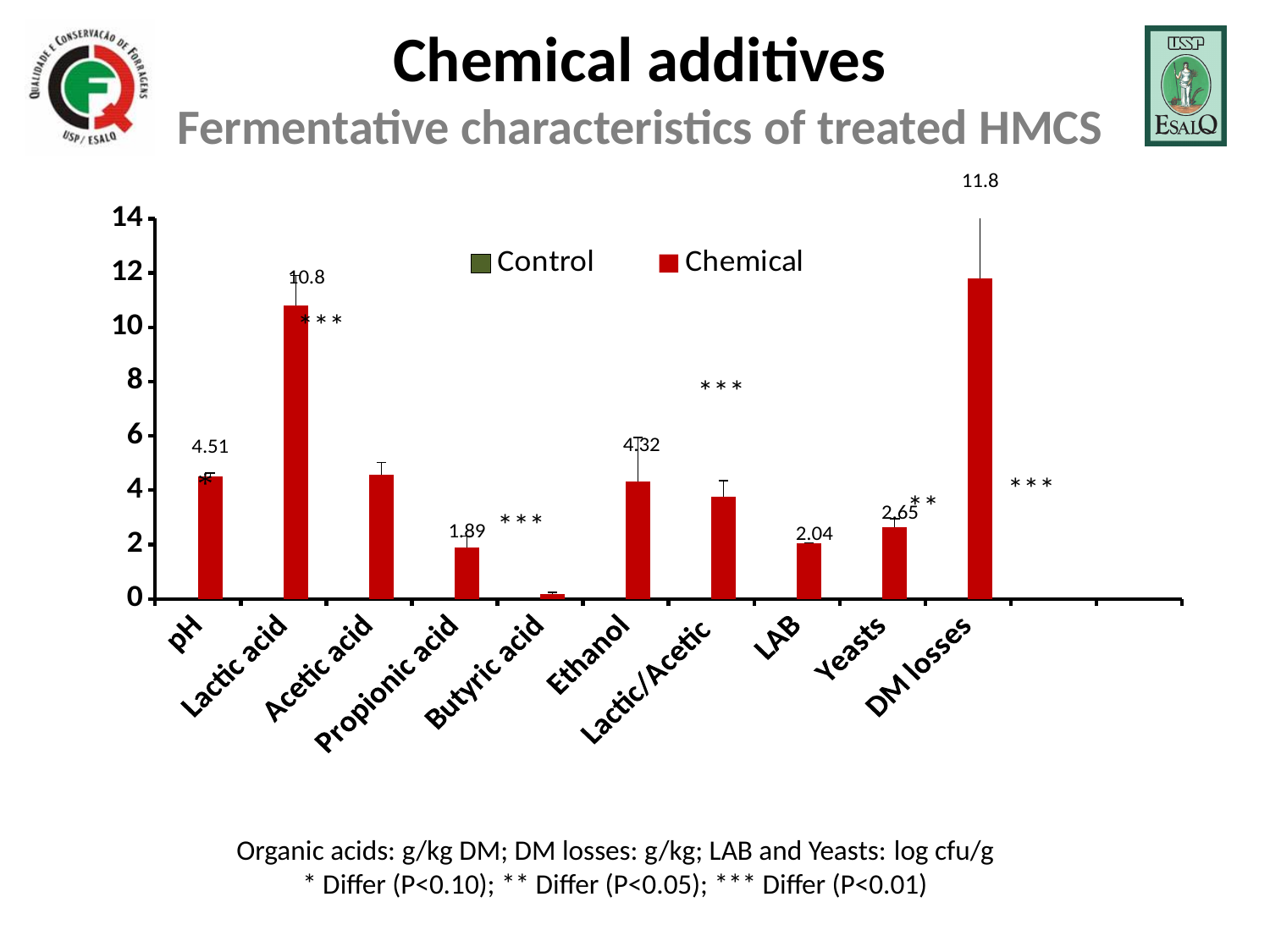
Which category has the highest value? DM losses What kind of chart is shown on the slide? bar chart Which is larger, the value for pH or the value for Ethanol? pH How many series does the legend list? 2 Which category has the lowest value? Butyric acid What is the value shown for Yeasts? 2.65 What is the value shown for Lactic acid? 10.8 What is the value shown for DM losses? 11.8 What is the value shown for Propionic acid? 1.89 Is the value for Acetic acid greater or less than 4? greater How many categories are shown on the x axis? 10 What is the difference between the values for DM losses and Lactic acid? 1.0